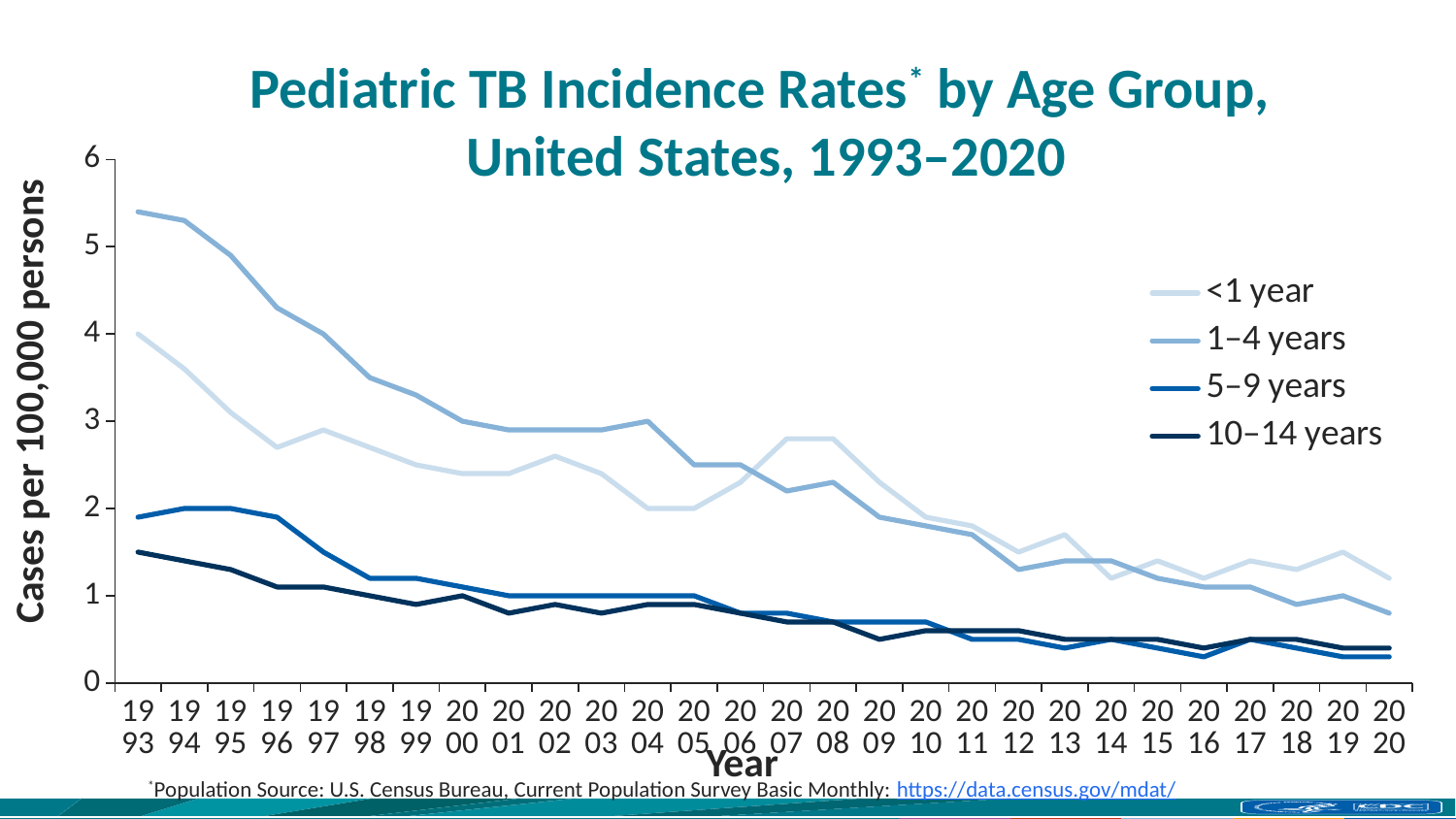
Is the value for the 1–4 years group in 2020 greater or less than 1? less How many series does the legend list? 4 How many years are plotted along the x axis? 28 What kind of chart is shown on the slide? line chart What is the label of the y axis? Cases per 100,000 persons Is the value for the 1–4 years group in 1993 greater or less than 5? greater Does the TB incidence rate for the 1–4 years group generally rise or fall from 1993 to 2020? fall In 2020, which is higher: the rate for the <1 year group or the 1–4 years group? <1 year Is the value for the <1 year group in 2007 greater or less than 2? greater Which age group had the lowest TB incidence rate in 1993? 10–14 years Which age group had the highest TB incidence rate in 1993? 1–4 years